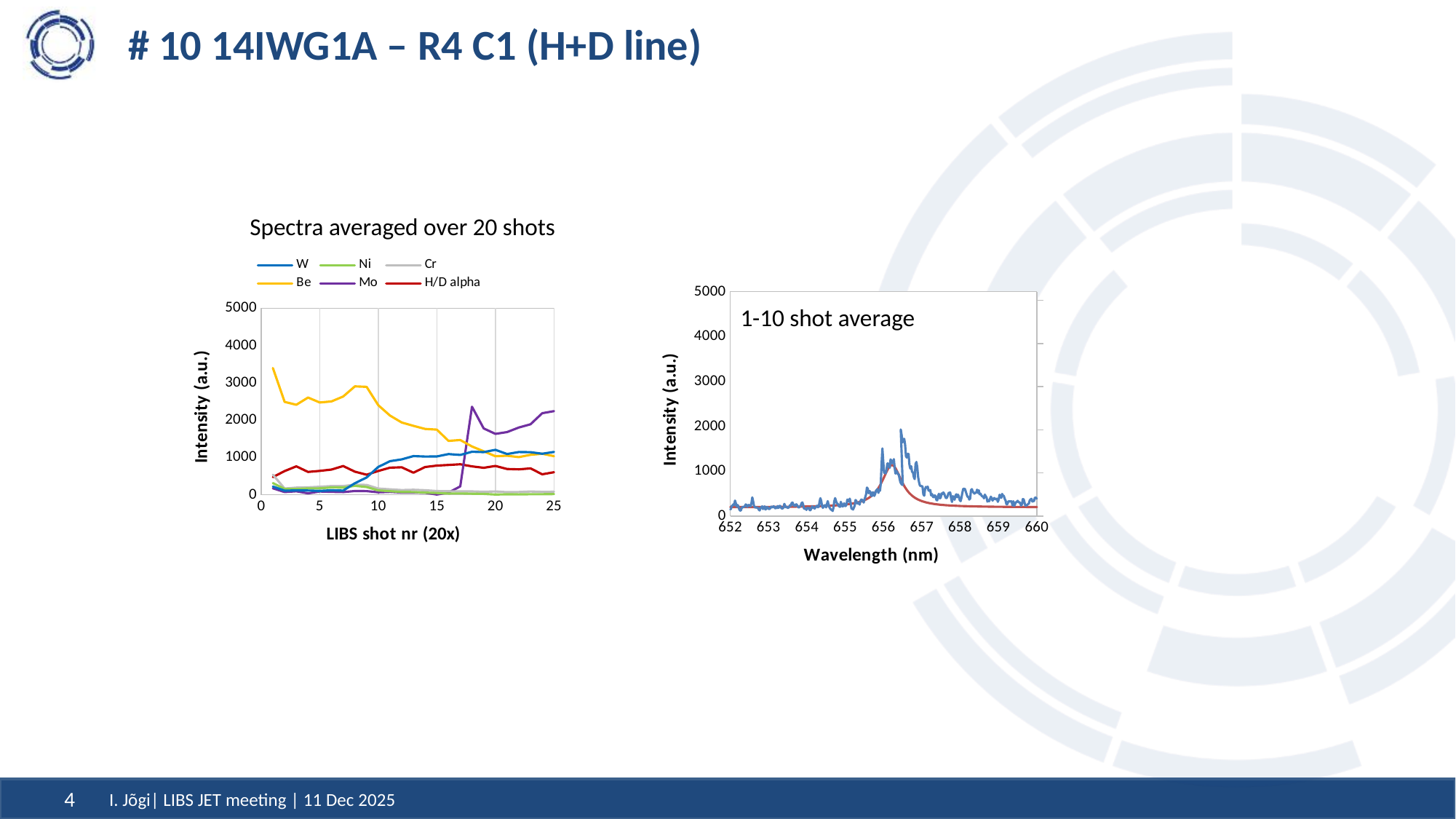
In the "Spectra averaged over 20 shots" chart, which series is larger at LIBS shot nr 25, Mo or H/D alpha? Mo In the right-hand chart labelled "1-10 shot average", is the peak intensity near 656 nm greater or less than 1000? greater In the "Spectra averaged over 20 shots" chart, is the Be value at LIBS shot nr 1 greater or less than 3000? greater In the chart titled "Spectra averaged over 20 shots", how many series does the legend list? 6 In the "Spectra averaged over 20 shots" chart, does the W series generally rise or fall as the LIBS shot nr increases? rise What kind of chart is the "Spectra averaged over 20 shots" chart? Line chart In the "Spectra averaged over 20 shots" chart, does the Be series generally rise or fall as the LIBS shot nr increases? fall In the "Spectra averaged over 20 shots" chart, is the Mo value at LIBS shot nr 10 greater or less than 1000? less In the right-hand chart labelled "1-10 shot average", what is the label of the x axis? Wavelength (nm) In the "Spectra averaged over 20 shots" chart, what is the label of the x axis? LIBS shot nr (20x) In the "Spectra averaged over 20 shots" chart, which series is larger at LIBS shot nr 5, Be or W? Be